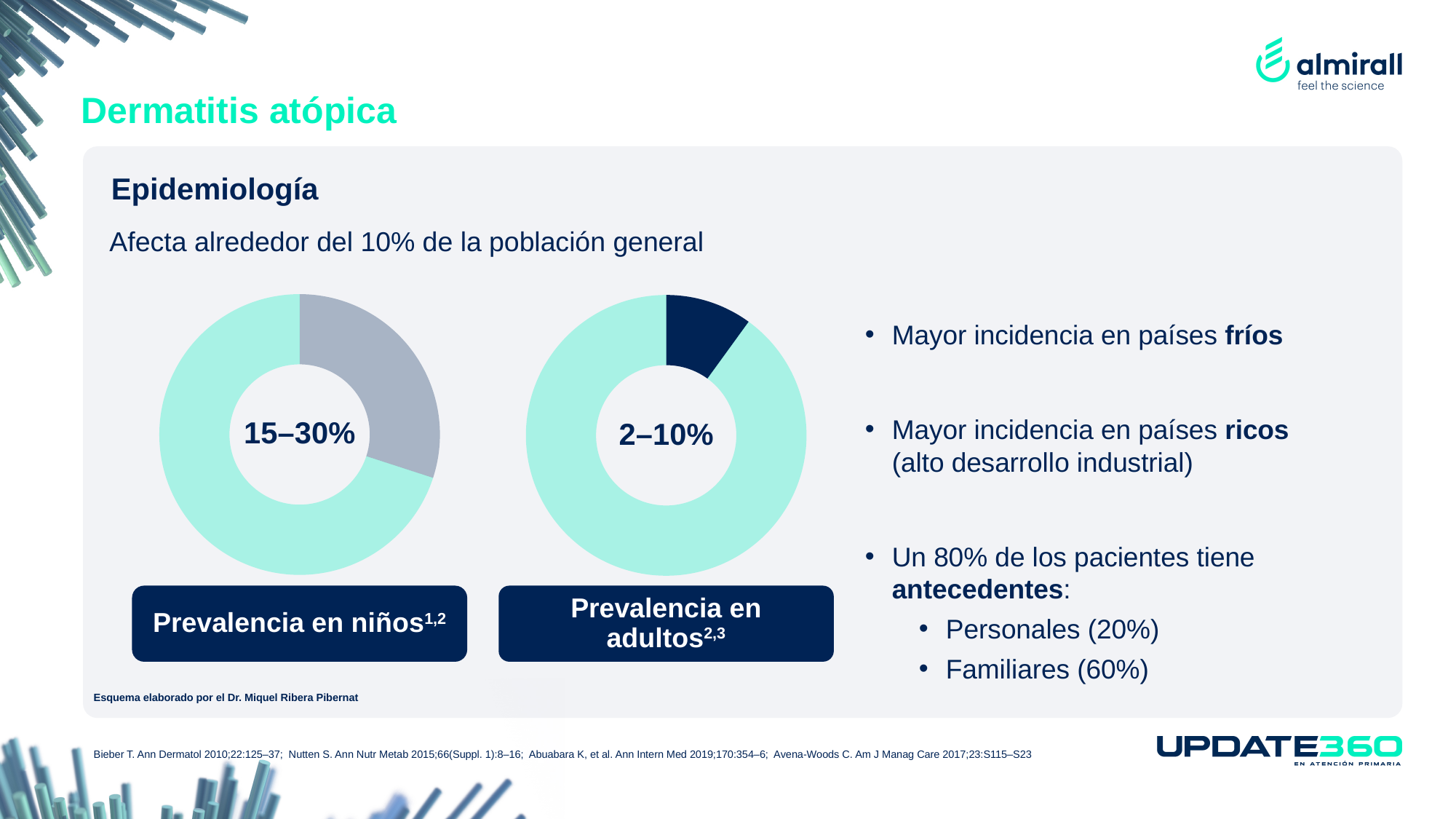
What is the label under the left donut chart? Prevalencia en niños What value is shown in the centre of the 'Prevalencia en adultos' donut chart? 2–10% What kind of chart is used to show the prevalence in children? Donut (pie) chart Which group shows a higher prevalence range, children ('niños') or adults ('adultos')? Children (niños) What is the label under the right donut chart? Prevalencia en adultos What kind of chart is used to show the prevalence in adults? Donut (pie) chart What value is shown in the centre of the 'Prevalencia en niños' donut chart? 15–30% Which donut chart has the larger highlighted slice, 'Prevalencia en niños' or 'Prevalencia en adultos'? Prevalencia en niños How many donut charts are shown on the slide? 2 What colour is the highlighted slice in the 'Prevalencia en adultos' donut chart? Dark navy blue